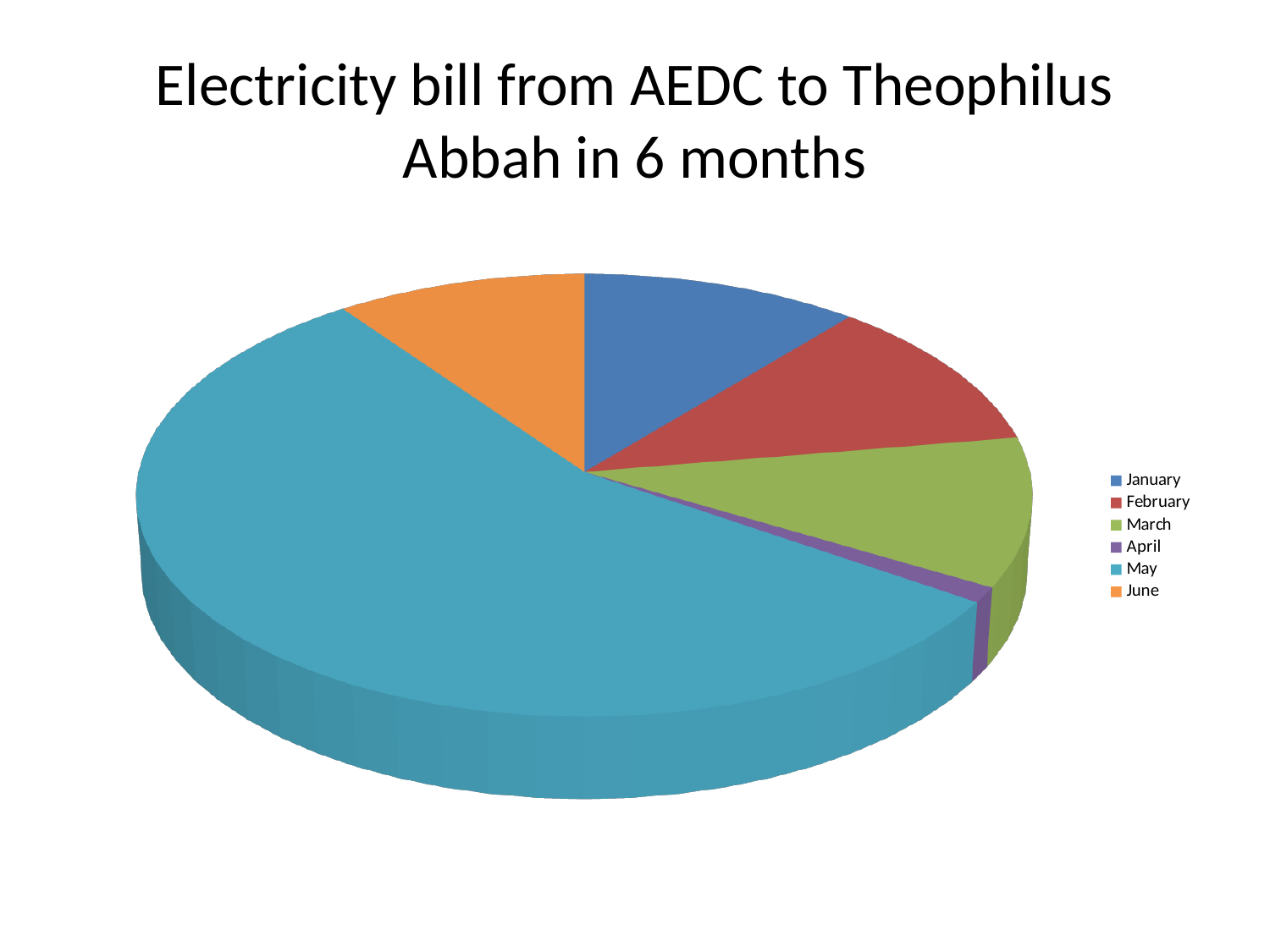
Which month has the smallest slice of the pie? April Which month has the largest slice of the pie? May What kind of chart is shown on the slide? pie chart How many entries does the legend list? 6 Which slice is larger, May or June? May Which slice is larger, January or April? January Which month is shown in orange in the legend? June How many months (slices) does the pie chart show? 6 What is the title of the chart? Electricity bill from AEDC to Theophilus Abbah in 6 months Which slice is larger, April or March? March